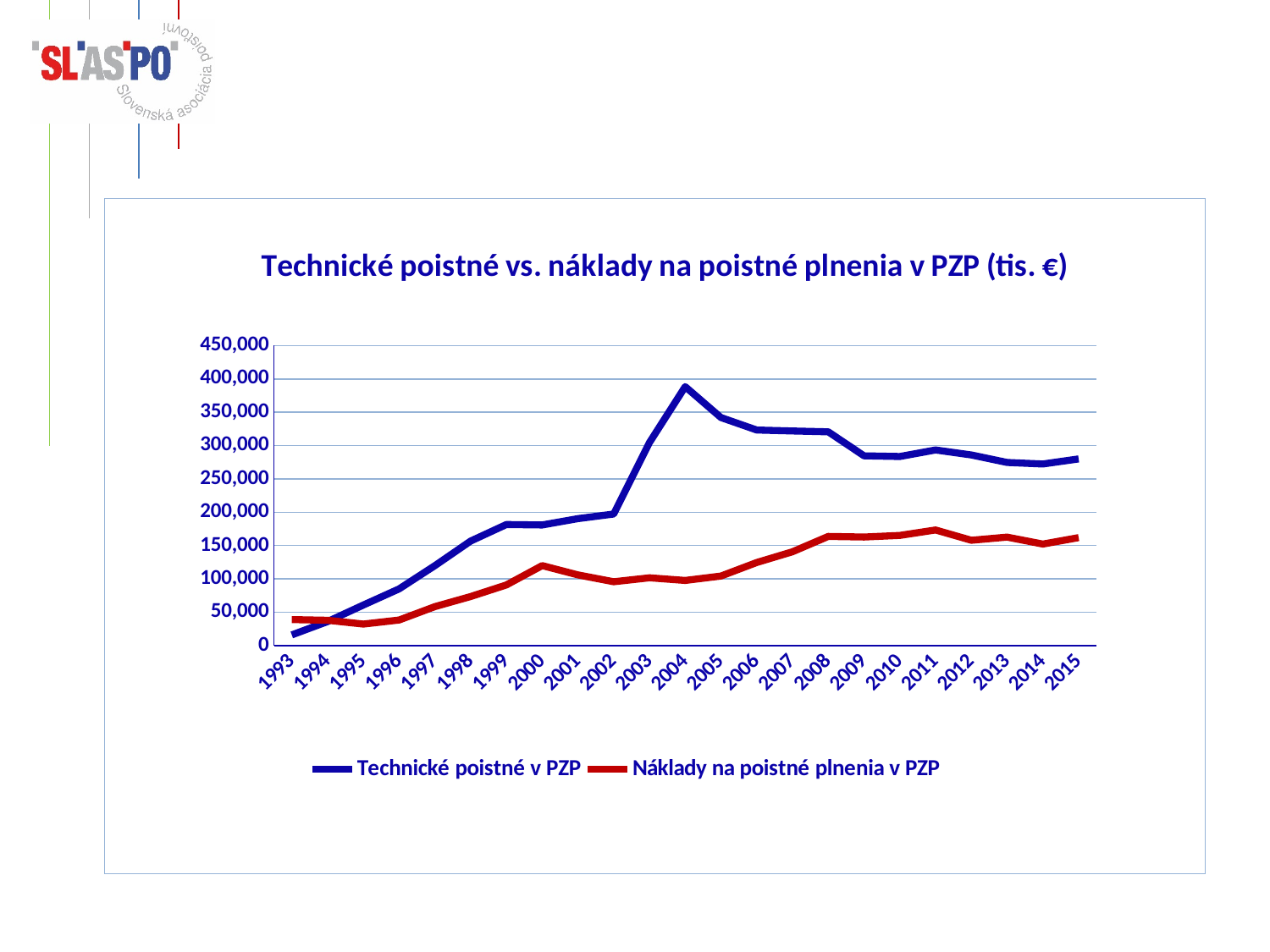
What kind of chart is shown on the slide? line chart How many years are plotted along the x axis? 23 Is the value of Technické poistné v PZP in 2004 greater or less than 350,000? greater Does the Technické poistné v PZP series rise or fall between 2004 and 2015? fall Which series has the larger value in 2004, Technické poistné v PZP or Náklady na poistné plnenia v PZP? Technické poistné v PZP In which year is the Technické poistné v PZP series at its lowest value? 1993 How many series does the legend list? 2 In which year does the Náklady na poistné plnenia v PZP series reach its highest value? 2011 What is the title of the chart? Technické poistné vs. náklady na poistné plnenia v PZP (tis. €) Is the value of Náklady na poistné plnenia v PZP in 2011 greater or less than 150,000? greater Is the value of Technické poistné v PZP in 2015 greater or less than 300,000? less In which year does the Technické poistné v PZP series reach its highest value? 2004